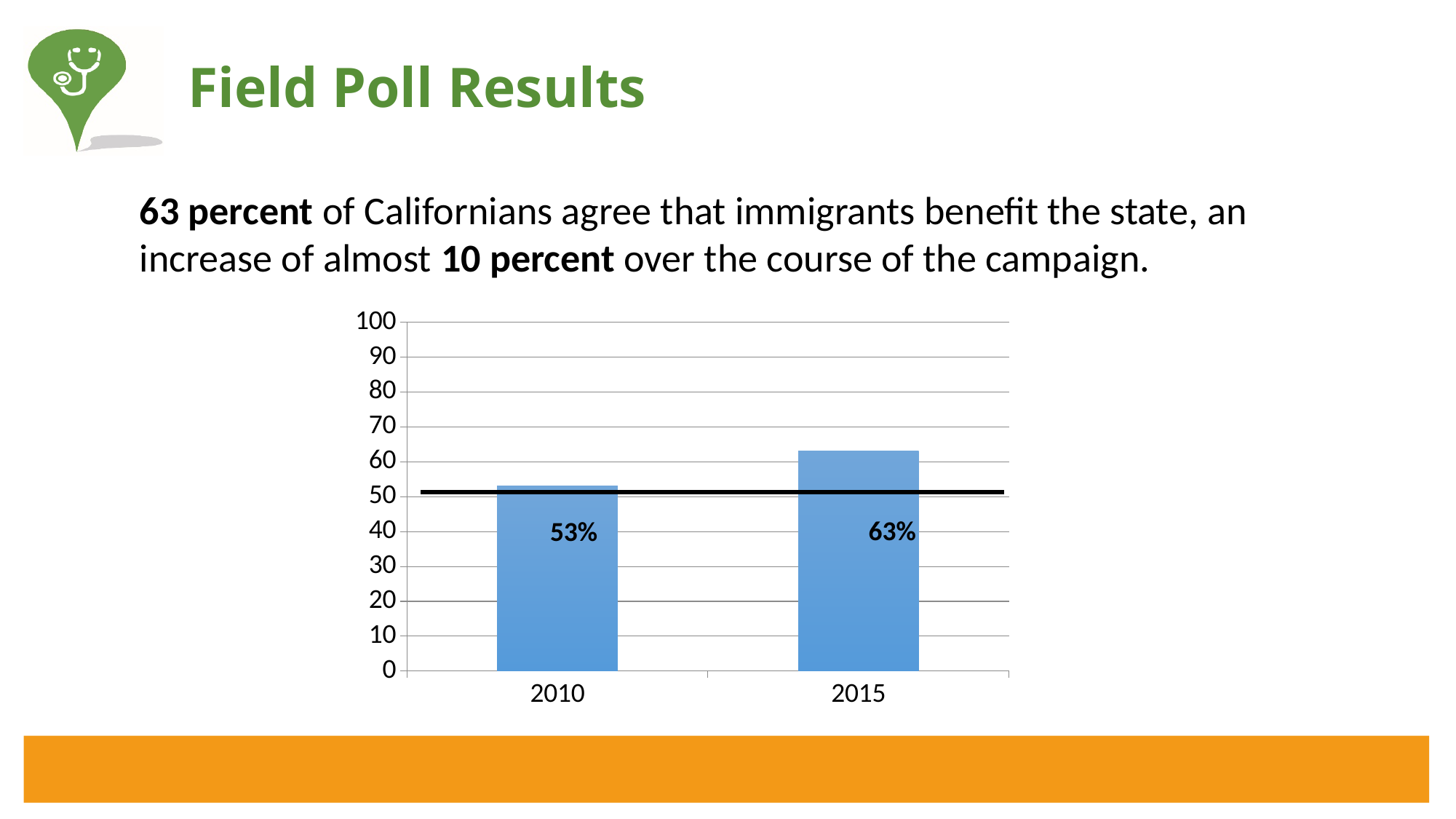
What is the difference between the 2015 and 2010 values? 10% Which year has the lower value? 2010 How many bars are shown in the chart? 2 Which year has the higher value? 2015 What is the value for 2015? 63% Is the value for 2015 larger than the value for 2010? Yes What is the maximum value shown on the vertical axis? 100 What is the value for 2010? 53% Is the value for 2015 greater or less than 50? greater Is the value for 2010 greater or less than 60? less Do the values rise or fall from 2010 to 2015? Rise What kind of chart is shown on the slide? Bar chart